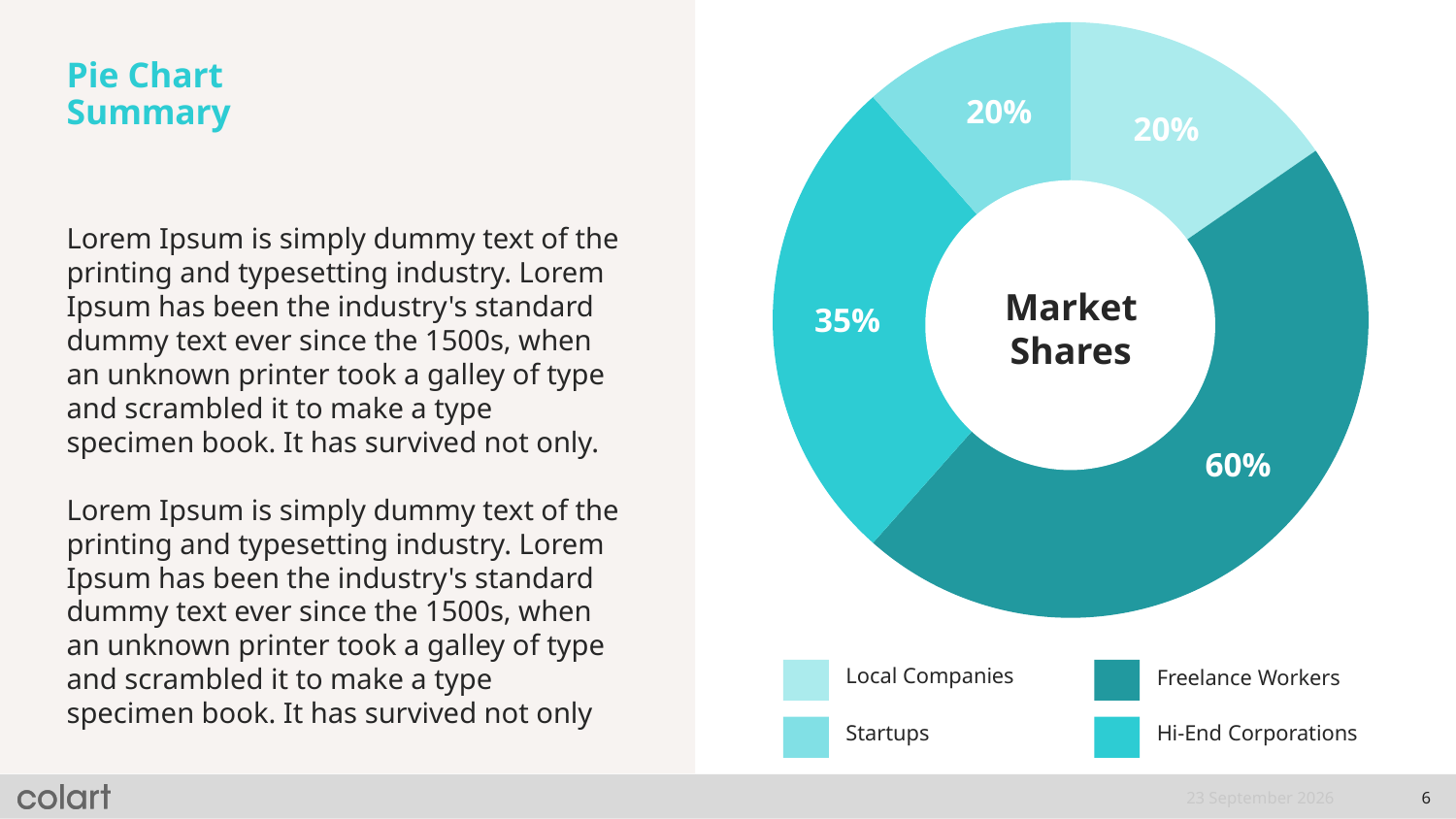
What is the title shown in the centre of the chart? Market Shares What type of chart is shown on the slide? Pie chart (donut) Which is larger, the slice for Hi-End Corporations or the slice for Local Companies? Hi-End Corporations What percentage is shown for Startups? 20% Which legend entry is shown in the darkest teal colour? Freelance Workers What percentage is shown for Local Companies? 20% What is the difference between the Freelance Workers and Hi-End Corporations percentages? 25% What is the difference between the Hi-End Corporations and Startups percentages? 15% How many categories does the legend list? 4 Which category has the largest slice of the chart? Freelance Workers What percentage is shown for Freelance Workers? 60% What percentage is shown for Hi-End Corporations? 35%